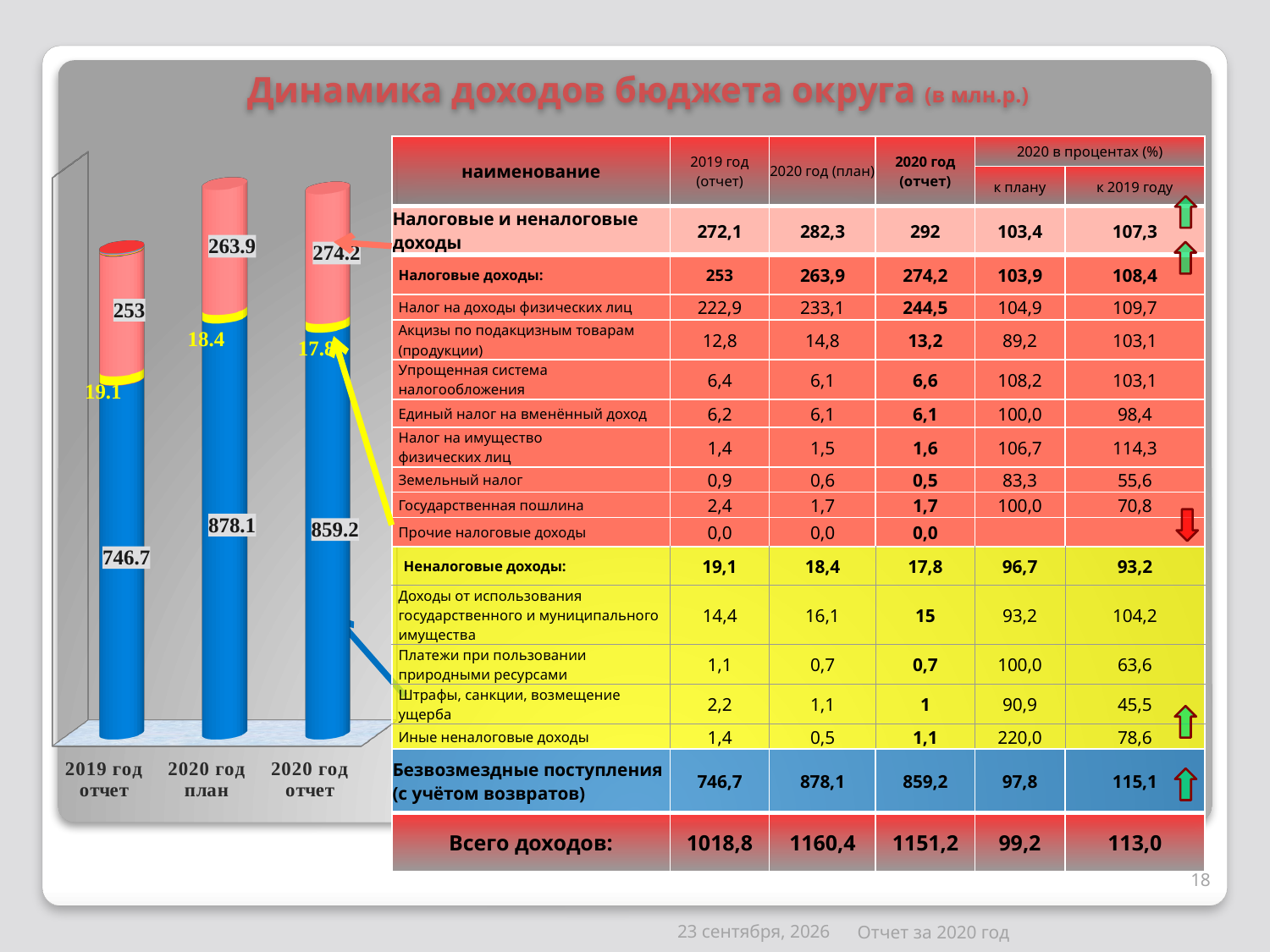
In the bar chart, which category has the highest value for the blue segment? 2020 год план What type of chart is shown on the left of the slide? bar chart In the bar chart, what is the total of the stacked bar for 2019 год отчет? 1018.8 Do the yellow segment values rise or fall from 2019 год отчет to 2020 год отчет in the bar chart? fall In the bar chart, what is the value of the blue segment for 2019 год отчет? 746.7 In the bar chart, what is the value of the pink segment for 2019 год отчет? 253 In the bar chart, which category has the lowest value for the pink segment? 2019 год отчет How many categories are shown on the x axis of the bar chart? 3 In the bar chart, is the pink segment larger for 2020 год отчет or for 2019 год отчет? 2020 год отчет In the bar chart, what is the value of the pink segment for 2020 год план? 263.9 In the bar chart, what is the difference between the blue segment values for 2020 год план and 2020 год отчет? 18.9 In the bar chart, what is the value of the yellow segment for 2020 год отчет? 17.8